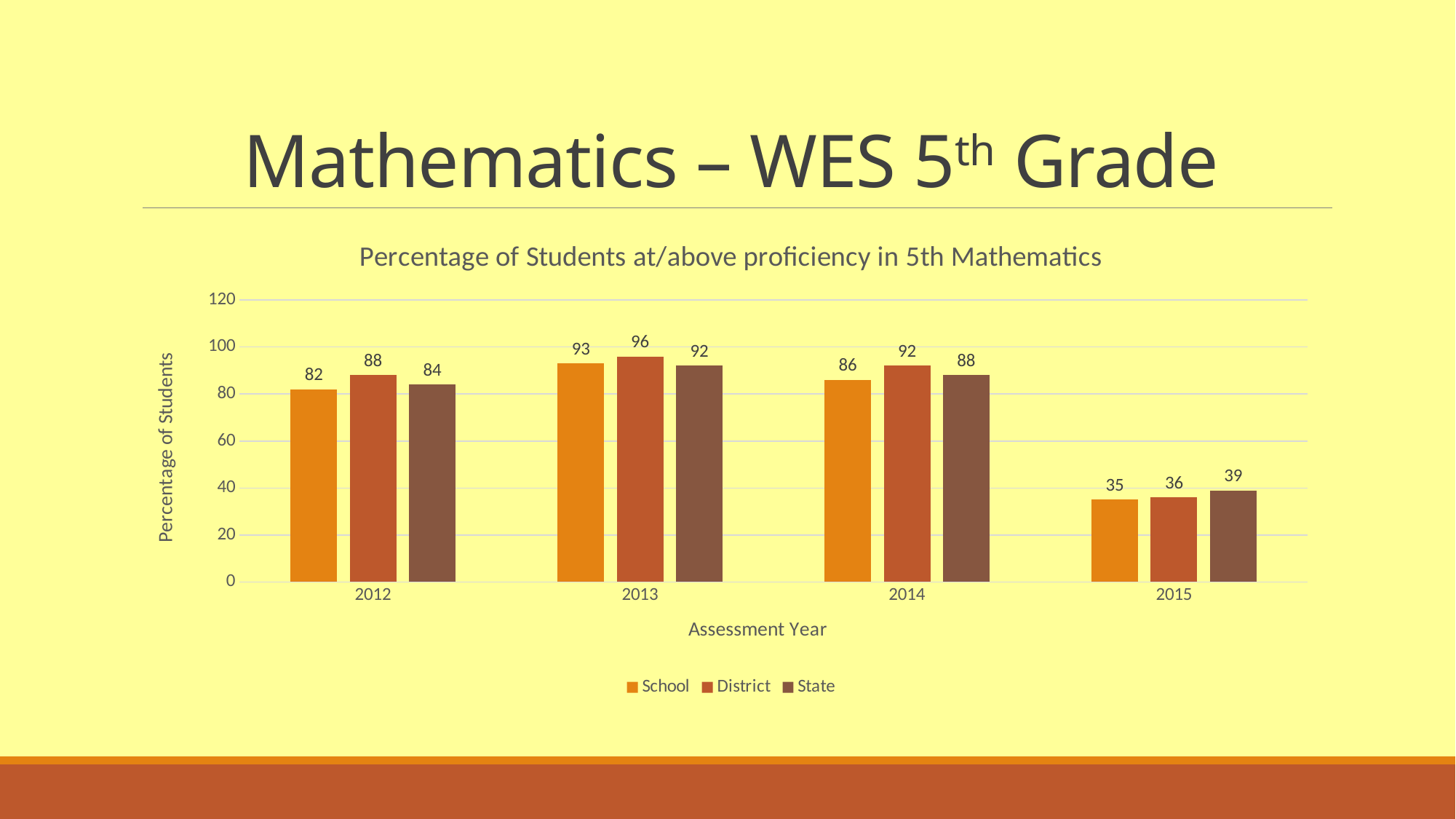
How many series does the legend list? 3 What is the District value for 2012? 88 How many assessment years are shown on the x axis? 4 In which year is the District value highest? 2013 What kind of chart is shown on the slide? Bar chart What is the School value for 2013? 93 Which is larger in 2012, the School value or the State value? State What is the difference between the District and School values in 2014? 6 Is the State value for 2014 greater or less than 60? greater In which year is the School value lowest? 2015 What is the title of the chart? Percentage of Students at/above proficiency in 5th Mathematics What is the State value for 2015? 39